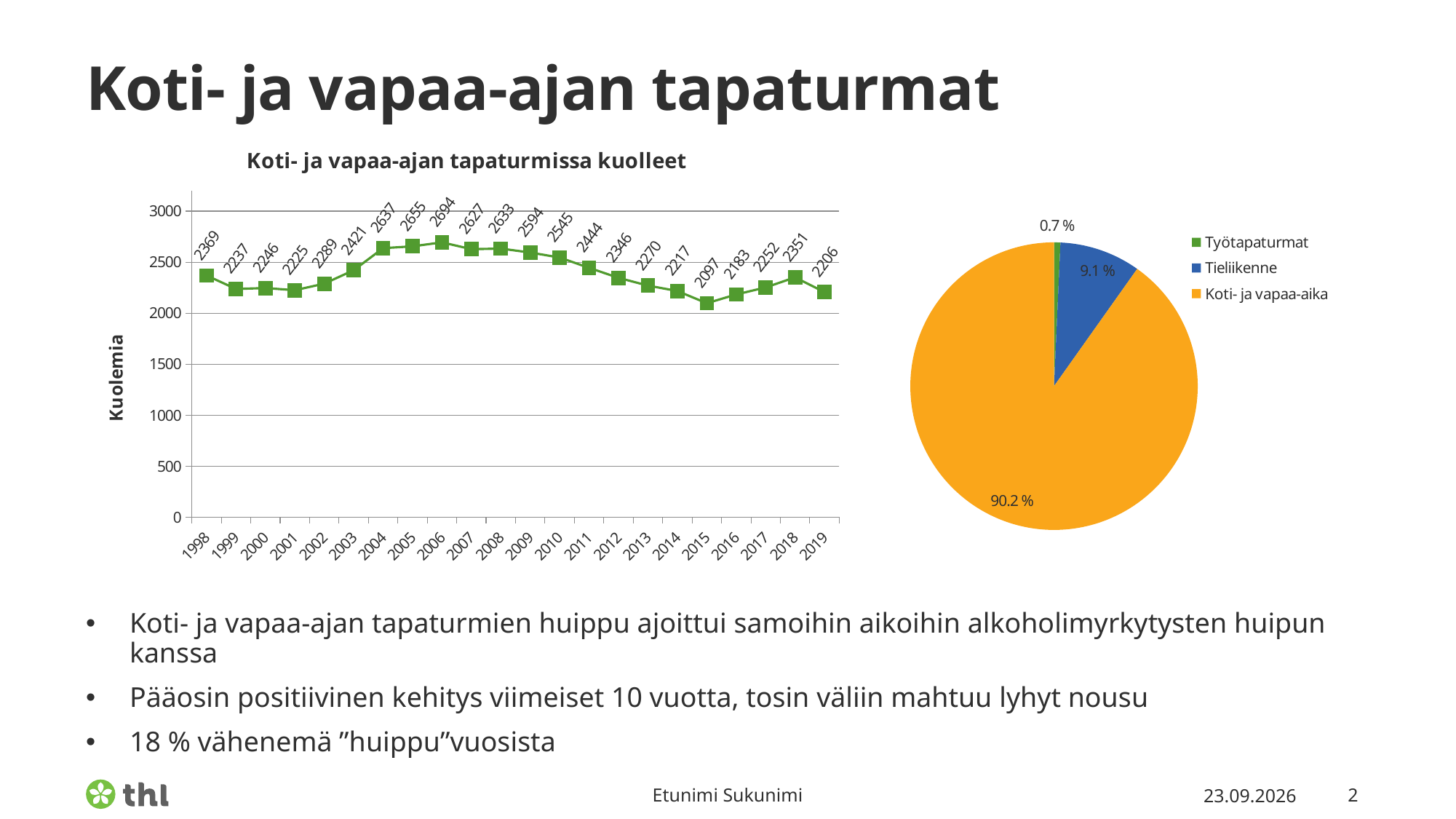
What type of chart is the chart on the left of the slide? line chart In the line chart 'Koti- ja vapaa-ajan tapaturmissa kuolleet', what is the value for 2015? 2097 In the line chart 'Koti- ja vapaa-ajan tapaturmissa kuolleet', what is the difference between the values for 2006 and 2015? 597 In the line chart 'Koti- ja vapaa-ajan tapaturmissa kuolleet', do the values rise or fall from 2006 to 2015? fall In the pie chart on the right, what share does Tieliikenne have? 9.1 % In the pie chart on the right, which category has the largest slice? Koti- ja vapaa-aika In the line chart 'Koti- ja vapaa-ajan tapaturmissa kuolleet', which year has the lowest value? 2015 In the line chart 'Koti- ja vapaa-ajan tapaturmissa kuolleet', how many years are plotted? 22 In the line chart 'Koti- ja vapaa-ajan tapaturmissa kuolleet', which is larger, the value for 1998 or the value for 2019? 1998 How many categories does the legend of the pie chart on the right list? 3 In the line chart 'Koti- ja vapaa-ajan tapaturmissa kuolleet', what is the value for 2006? 2694 In the line chart 'Koti- ja vapaa-ajan tapaturmissa kuolleet', which year has the highest value? 2006